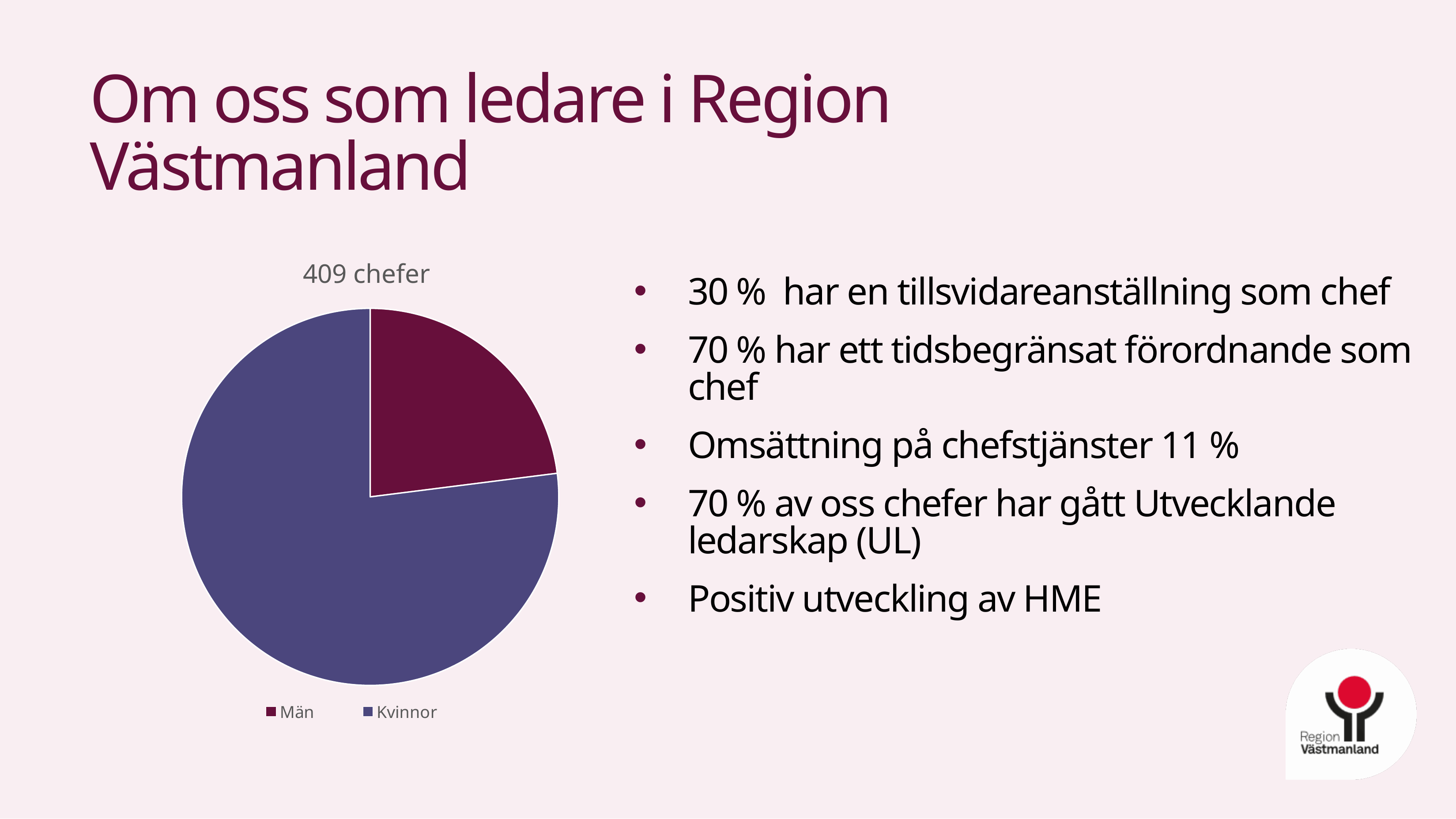
In the pie chart, which slice is larger, Män or Kvinnor? Kvinnor Which legend entry is shown in the dark red colour in the pie chart? Män How many entries does the legend of the pie chart list? 2 Which category has the smallest slice in the pie chart? Män What kind of chart is shown on the slide? pie chart How many slices does the pie chart have? 2 What is the title of the pie chart? 409 chefer Which category has the largest slice in the pie chart? Kvinnor